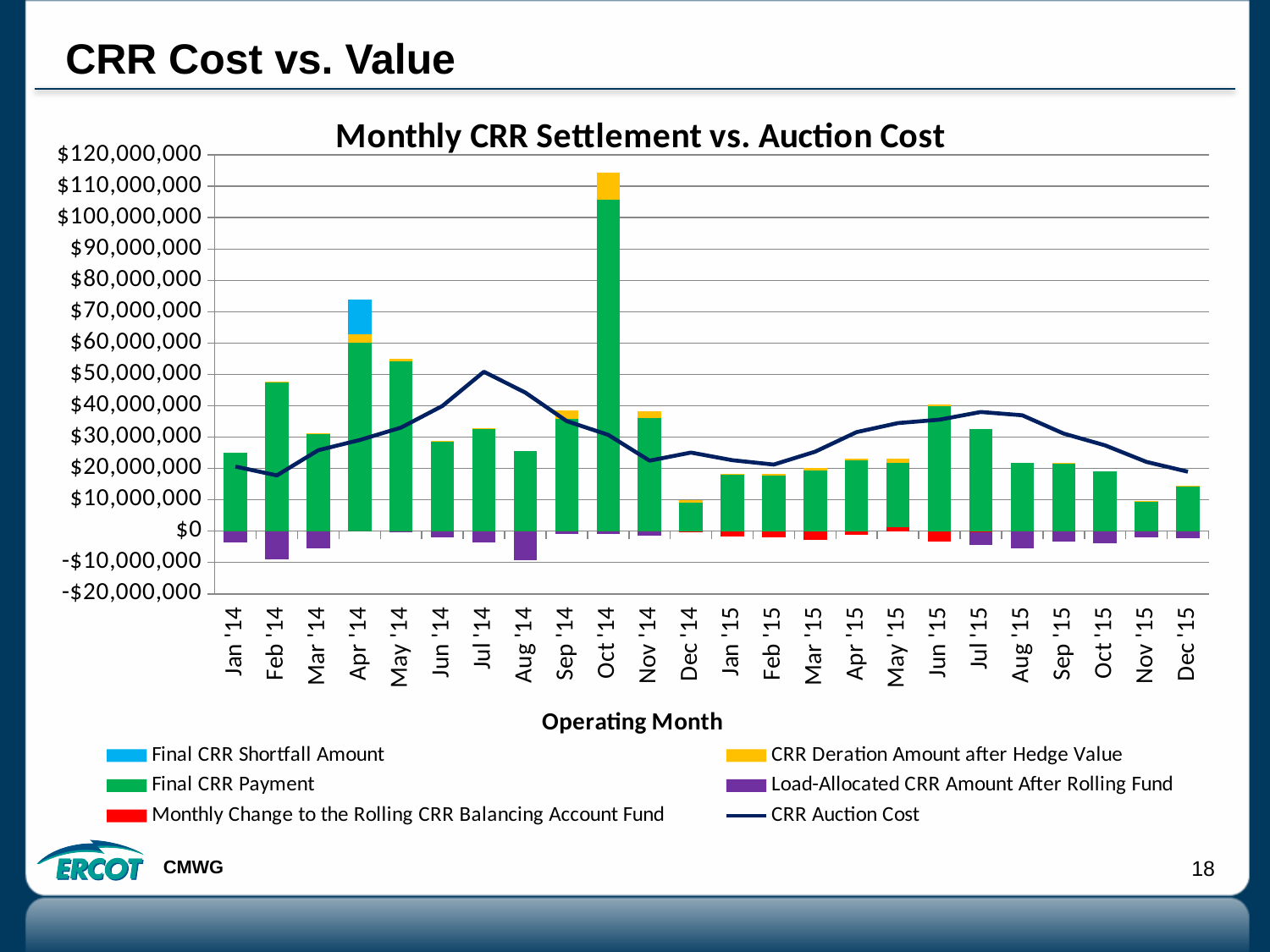
How many series does the legend list? 6 Is the Final CRR Payment for Oct '14 greater or less than $100,000,000? greater What is the title of the x axis? Operating Month Which operating month has the tallest stacked bar? Oct '14 Which has the taller stacked bar, Apr '14 or May '14? Apr '14 Is the Final CRR Payment for Dec '14 greater or less than $10,000,000? less Does the CRR Auction Cost line rise or fall from Jul '14 to Nov '14? fall What type of chart is shown on the slide? Bar chart with a line series Is the Final CRR Payment for Feb '14 greater or less than $40,000,000? greater In which operating month does the CRR Auction Cost line reach its highest point? Jul '14 How many operating months are shown on the x axis? 24